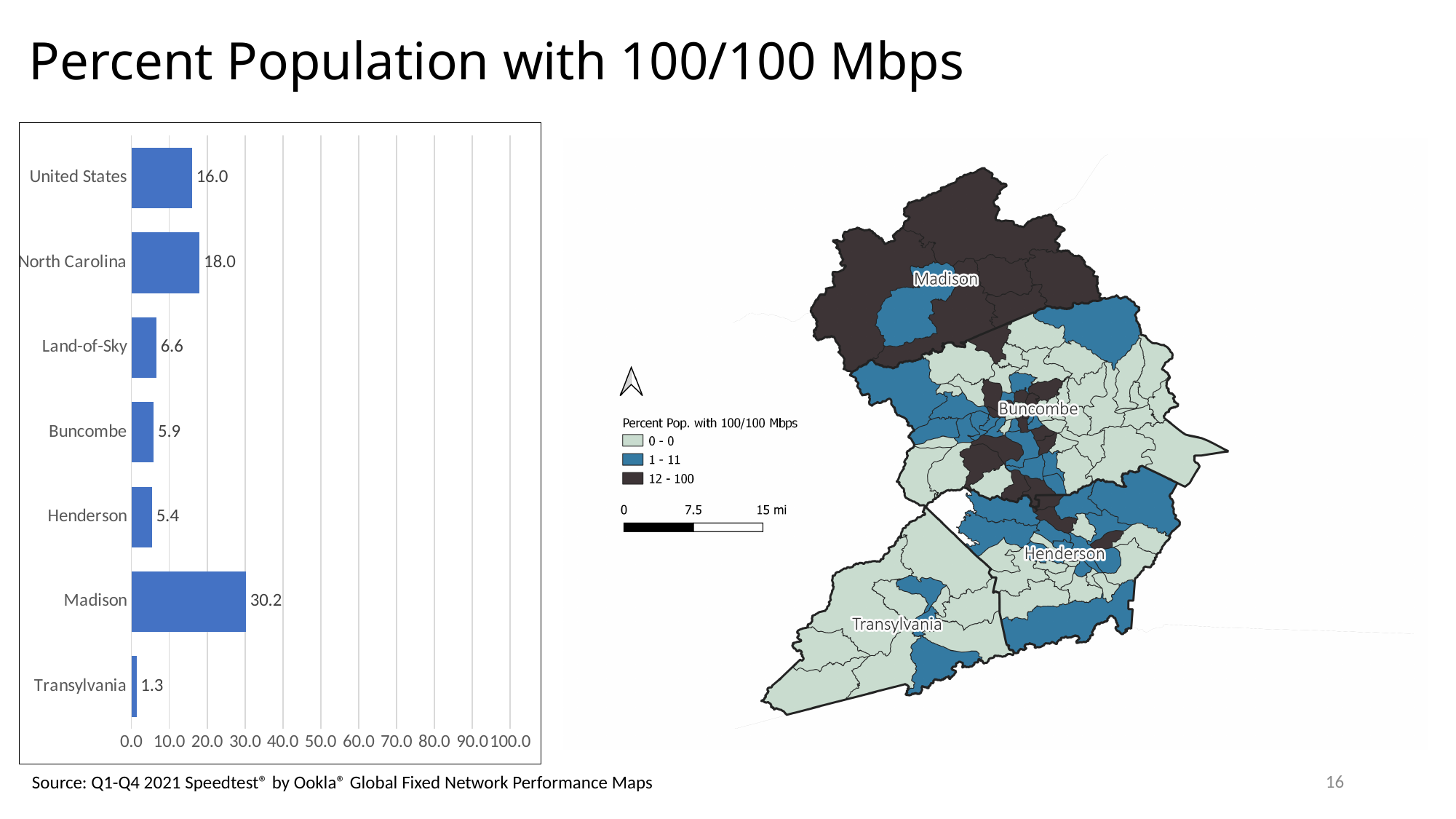
Is the value for Madison in the bar chart greater or less than 20.0? greater Which has a larger value in the bar chart, Buncombe or Henderson? Buncombe Which category has the highest value in the bar chart? Madison What kind of chart is shown on the left of the slide? Bar chart What is the difference between the values for North Carolina and the United States in the bar chart? 2.0 What is the value for North Carolina in the bar chart? 18.0 What is the value for Transylvania in the bar chart? 1.3 What is the value for Land-of-Sky in the bar chart? 6.6 How many categories are shown in the bar chart? 7 What is the difference between the values for Madison and Henderson in the bar chart? 24.8 What is the value for Madison in the bar chart? 30.2 Which category has the lowest value in the bar chart? Transylvania